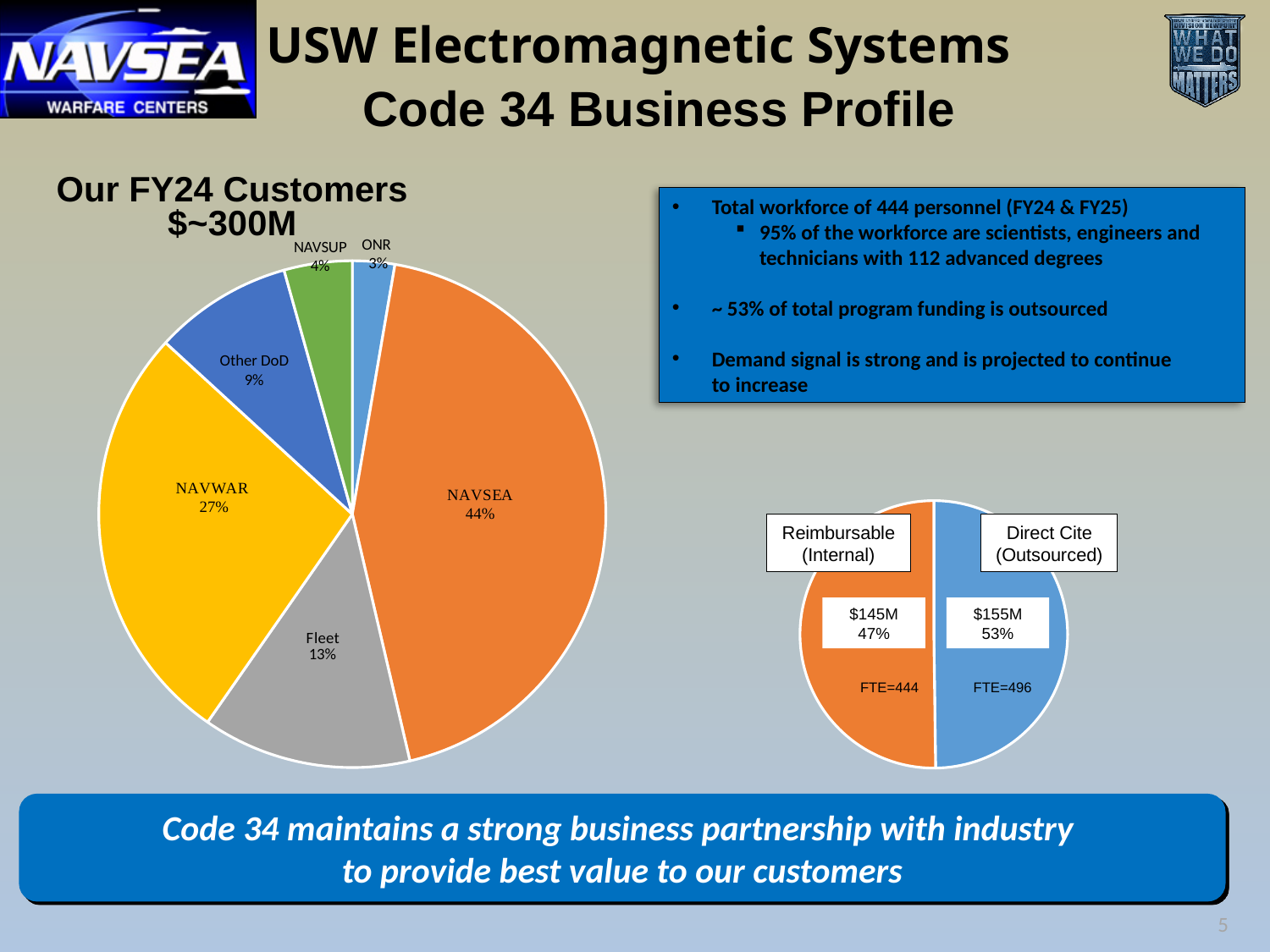
What kind of chart is the 'Our FY24 Customers' chart? Pie chart In the 'Our FY24 Customers' pie chart, which is larger, Other DoD or NAVSUP? Other DoD In the pie chart on the right of the slide, what is the dollar value for Direct Cite (Outsourced)? $155M In the 'Our FY24 Customers' pie chart, what is the difference in percentage points between NAVSEA and NAVWAR? 17 In the 'Our FY24 Customers' pie chart, which customer has the smallest share? ONR In the 'Our FY24 Customers' pie chart, what share does NAVWAR have? 27% In the 'Our FY24 Customers' pie chart, what share does NAVSEA have? 44% In the 'Our FY24 Customers' pie chart, what share does Fleet have? 13% In the pie chart on the right of the slide, what is the FTE value shown for Direct Cite (Outsourced)? FTE=496 In the 'Our FY24 Customers' pie chart, which customer has the largest share? NAVSEA In the 'Our FY24 Customers' pie chart, how many customer categories are shown? 6 In the pie chart on the right of the slide, what percentage is Reimbursable (Internal)? 47%